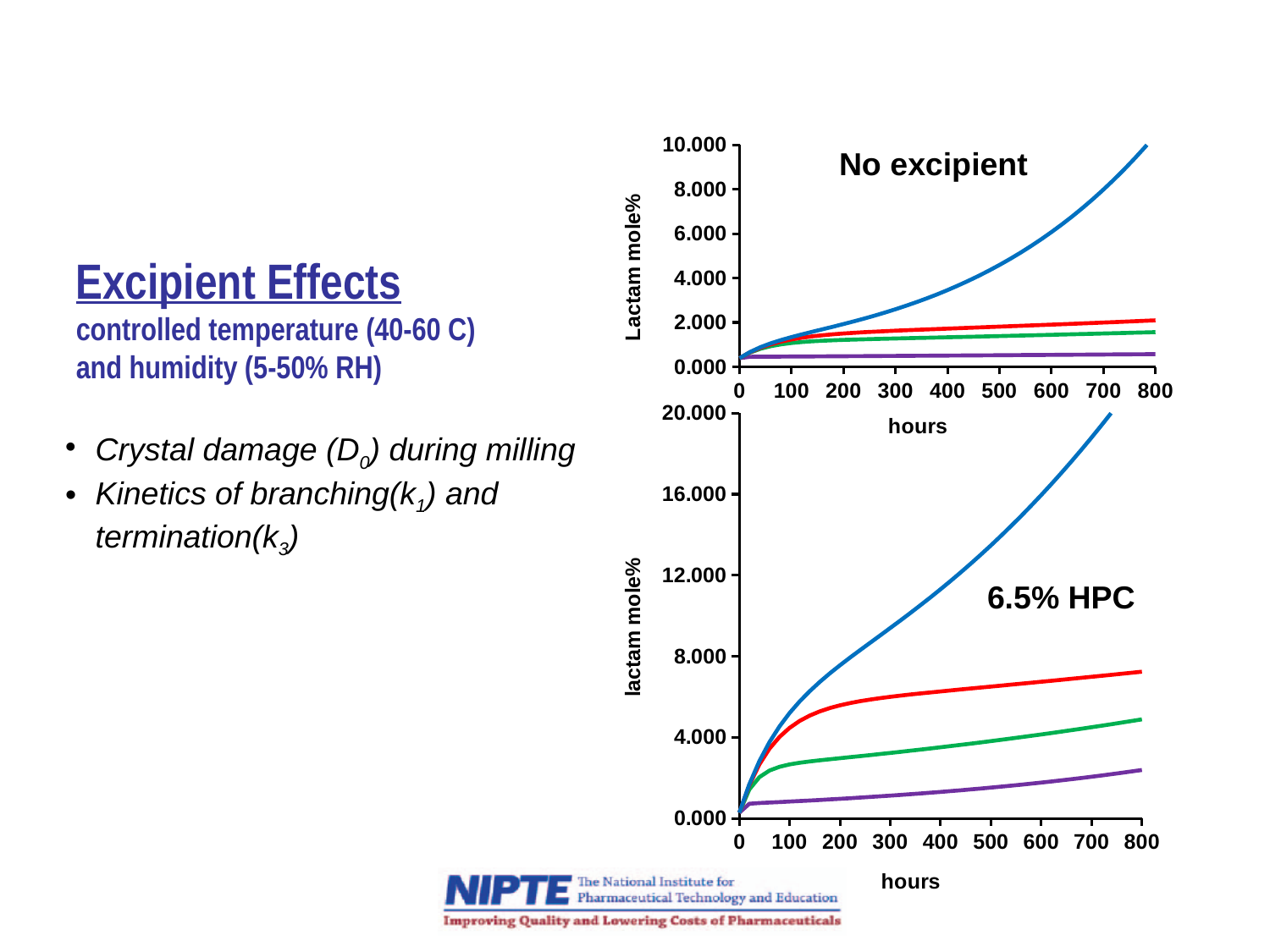
In the top chart titled "No excipient", does the blue line rise or fall as hours increase? rise How many lines are plotted in the bottom chart titled "6.5% HPC"? 4 In the top chart titled "No excipient", which coloured line stays lowest across the hours? purple In the bottom chart titled "6.5% HPC", is the value of the blue line at 600 hours greater or less than 12.000? greater How many lines are plotted in the top chart titled "No excipient"? 4 What kind of chart is the top chart titled "No excipient"? line chart In the top chart titled "No excipient", is the value of the red line at 800 hours greater or less than 4.000? less In the bottom chart titled "6.5% HPC", is the value of the red line at 800 hours greater or less than 8.000? less In the bottom chart titled "6.5% HPC", which is larger at 400 hours, the red line or the green line? red line What is the x-axis label of the bottom chart titled "6.5% HPC"? hours In the bottom chart titled "6.5% HPC", which coloured line reaches the highest value? blue